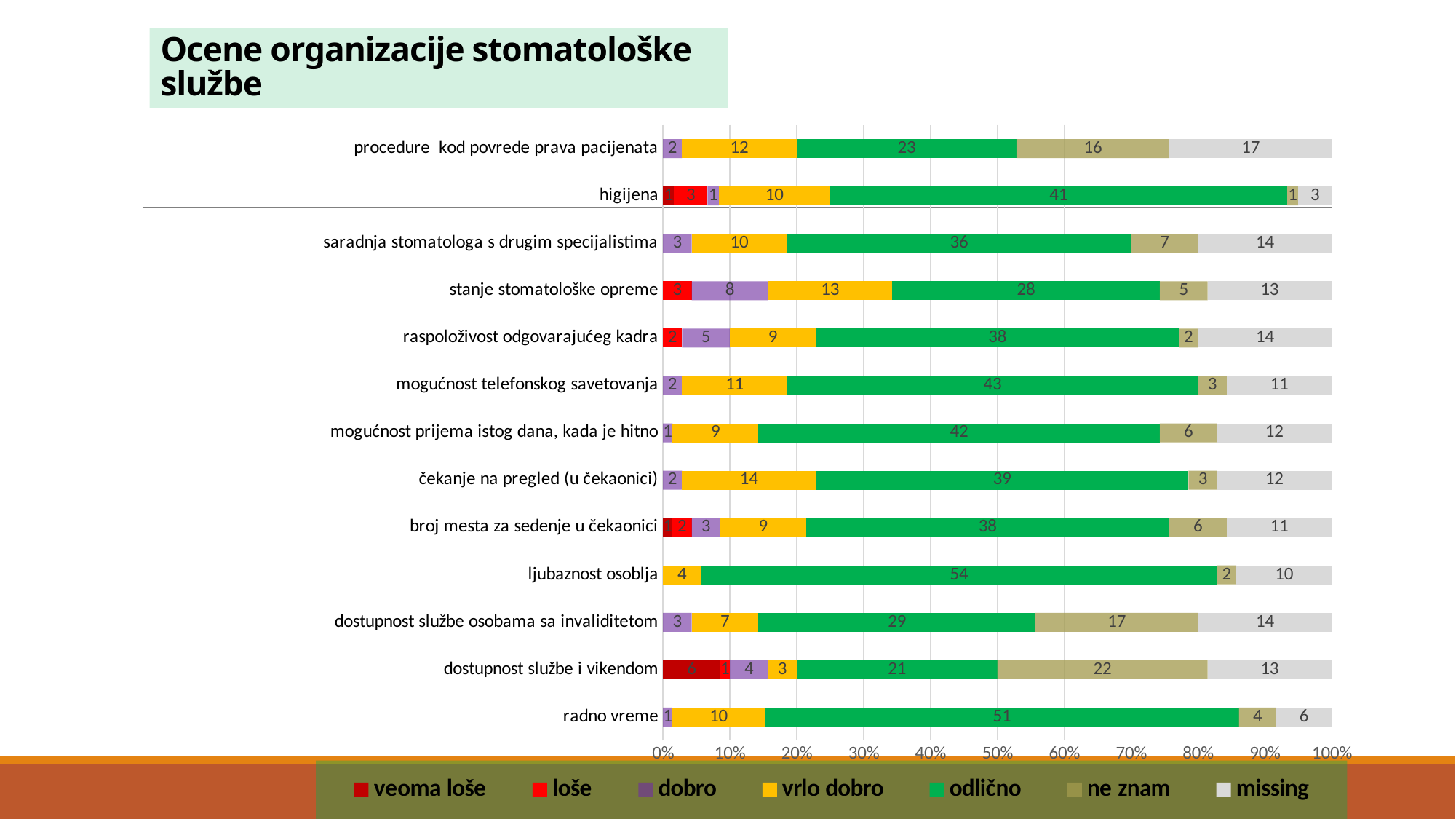
How many series does the legend list? 7 Which category has the highest 'odlično' value? ljubaznost osoblja What is the total of all labelled segments in the 'radno vreme' bar? 72 What is the 'odlično' value for 'ljubaznost osoblja'? 54 What kind of chart is shown on the slide? stacked bar chart What is the 'ne znam' value for 'dostupnost službe i vikendom'? 22 What is the 'vrlo dobro' value for 'čekanje na pregled (u čekaonici)'? 14 What is the 'missing' value for 'procedure kod povrede prava pacijenata'? 17 What is the difference between the 'odlično' values for 'radno vreme' and 'higijena'? 10 How many categories are shown on the chart? 13 Which is larger: the 'ne znam' value for 'dostupnost službe osobama sa invaliditetom' or for 'saradnja stomatologa s drugim specijalistima'? dostupnost službe osobama sa invaliditetom Which category has the lowest 'missing' value? higijena